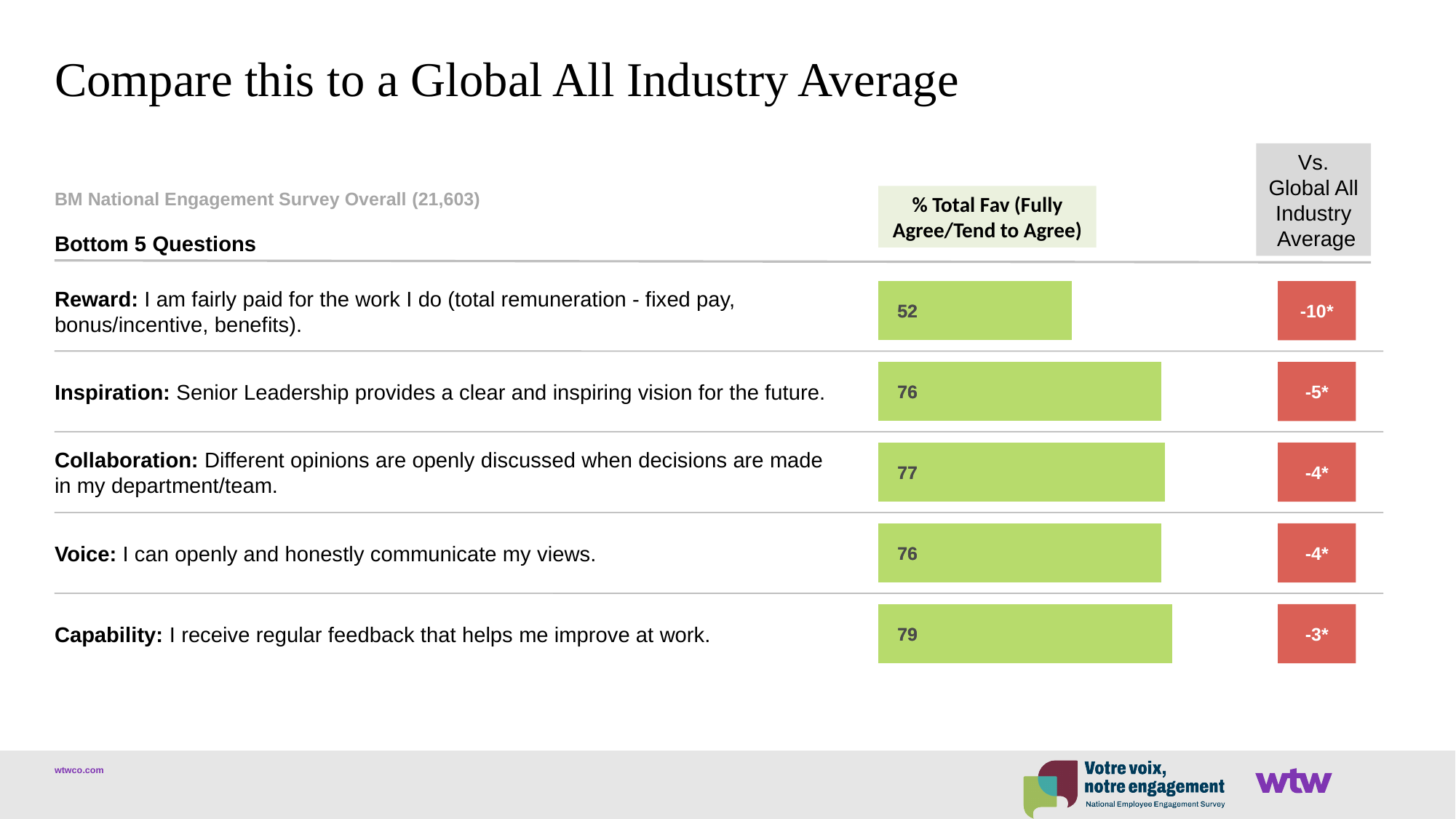
What is the Vs. Global All Industry Average value for the Inspiration question? -5* What kind of chart is used to show the % Total Fav values? Bar chart What is the % Total Fav value for the Collaboration question? 77 Which question has the highest % Total Fav value? Capability What is the difference in % Total Fav between the Capability and Reward questions? 27 What is the heading of the column showing the green bars? % Total Fav (Fully Agree/Tend to Agree) How many questions are shown in the chart? 5 What is the Vs. Global All Industry Average value for the Reward question? -10* What is the % Total Fav value for the Reward question? 52 What is the % Total Fav value for the Capability question? 79 Which question has the lowest % Total Fav value? Reward Which has a higher % Total Fav value, Collaboration or Voice? Collaboration